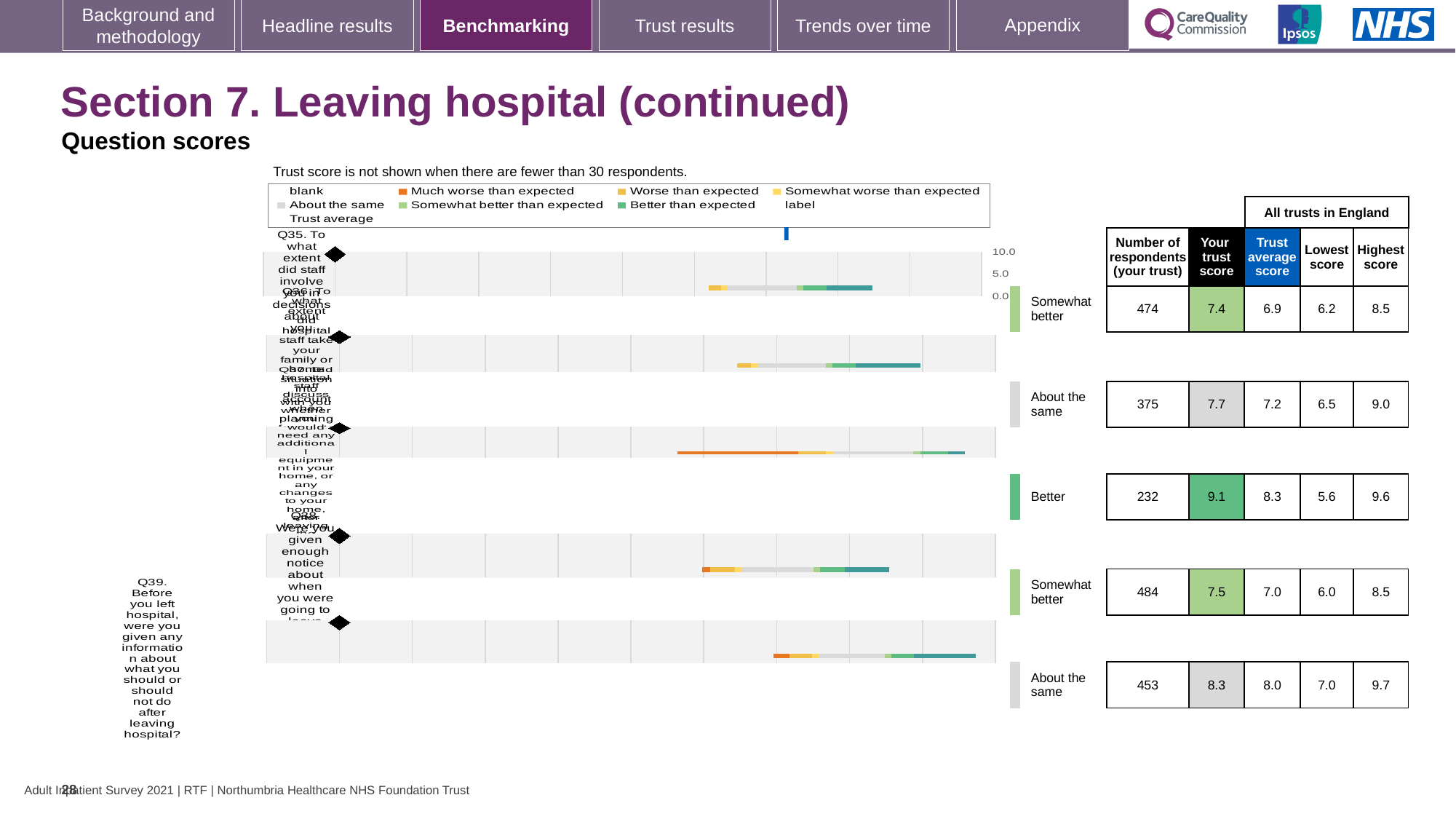
How many questions (Q35 to Q39) are plotted in the question scores chart? 5 Which question has the lowest number of respondents? Q37 Which has the larger trust score, Q36 or Q38? Q36 What benchmark category is shown for Q39? About the same What is the trust score for Q37 shown in the table next to the chart? 9.1 What is the difference between the trust score and the trust average score for Q37? 0.8 What is the trust average score for Q39? 8.0 What kind of chart is used to show the question scores on this slide? bar chart Which question has the highest trust score? Q37 Which legend entry is shown in orange? Much worse than expected What is the number of respondents for Q38? 484 What is the lowest score across all trusts in England for Q37? 5.6